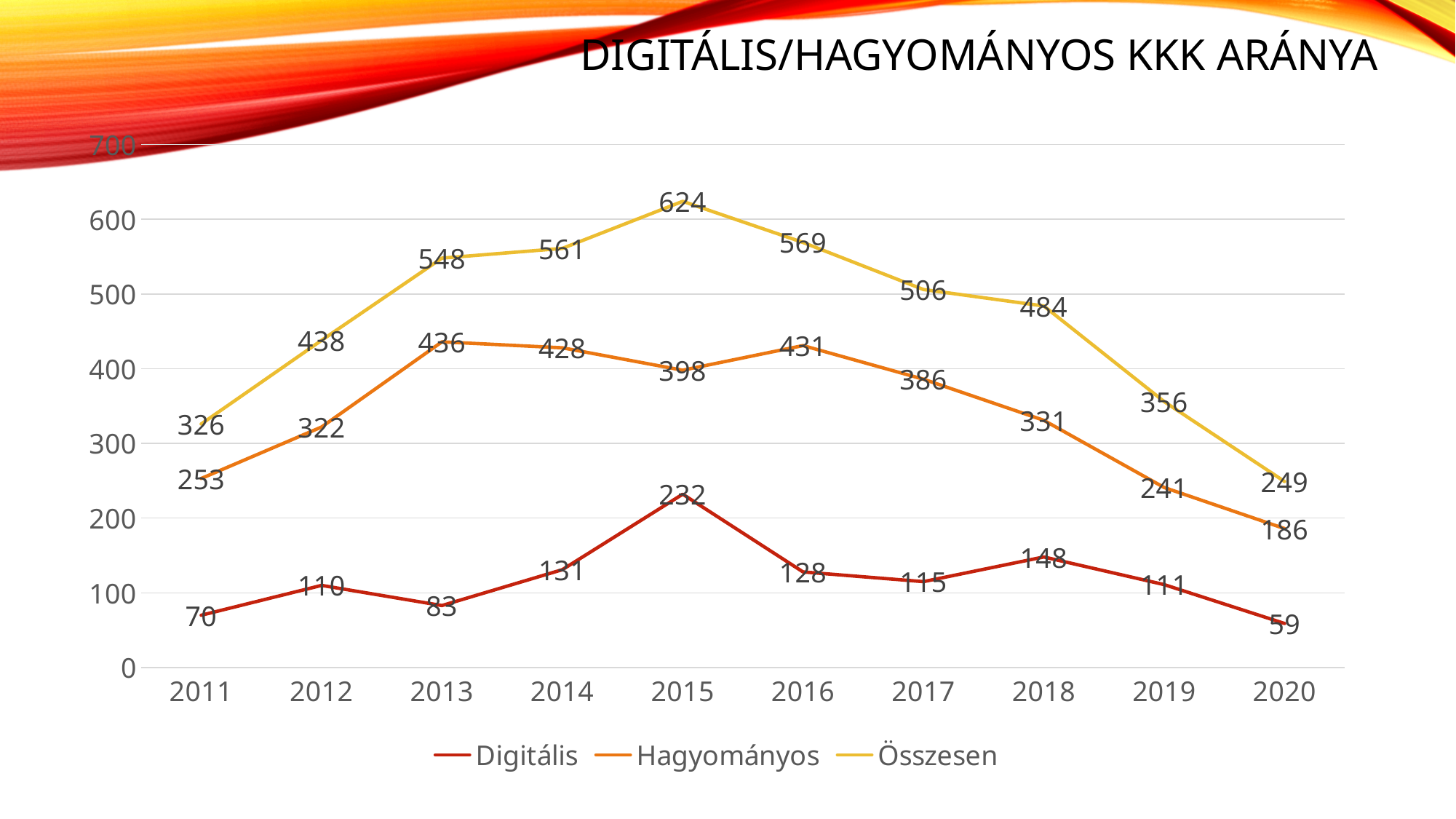
How many years are shown on the x axis? 10 How many series does the legend list? 3 Which is larger, Hagyományos in 2016 or Hagyományos in 2017? Hagyományos in 2016 Does the Összesen series rise or fall from 2015 to 2020? fall What is the value for Összesen in 2020? 249 In which year is the Digitális series lowest? 2020 What is the value for Hagyományos in 2013? 436 What is the value for Digitális in 2015? 232 What is the title of the chart? DIGITÁLIS/HAGYOMÁNYOS KKK ARÁNYA In which year is the Összesen series highest? 2015 What is the difference between Hagyományos and Digitális in 2011? 183 What kind of chart is shown on the slide? line chart